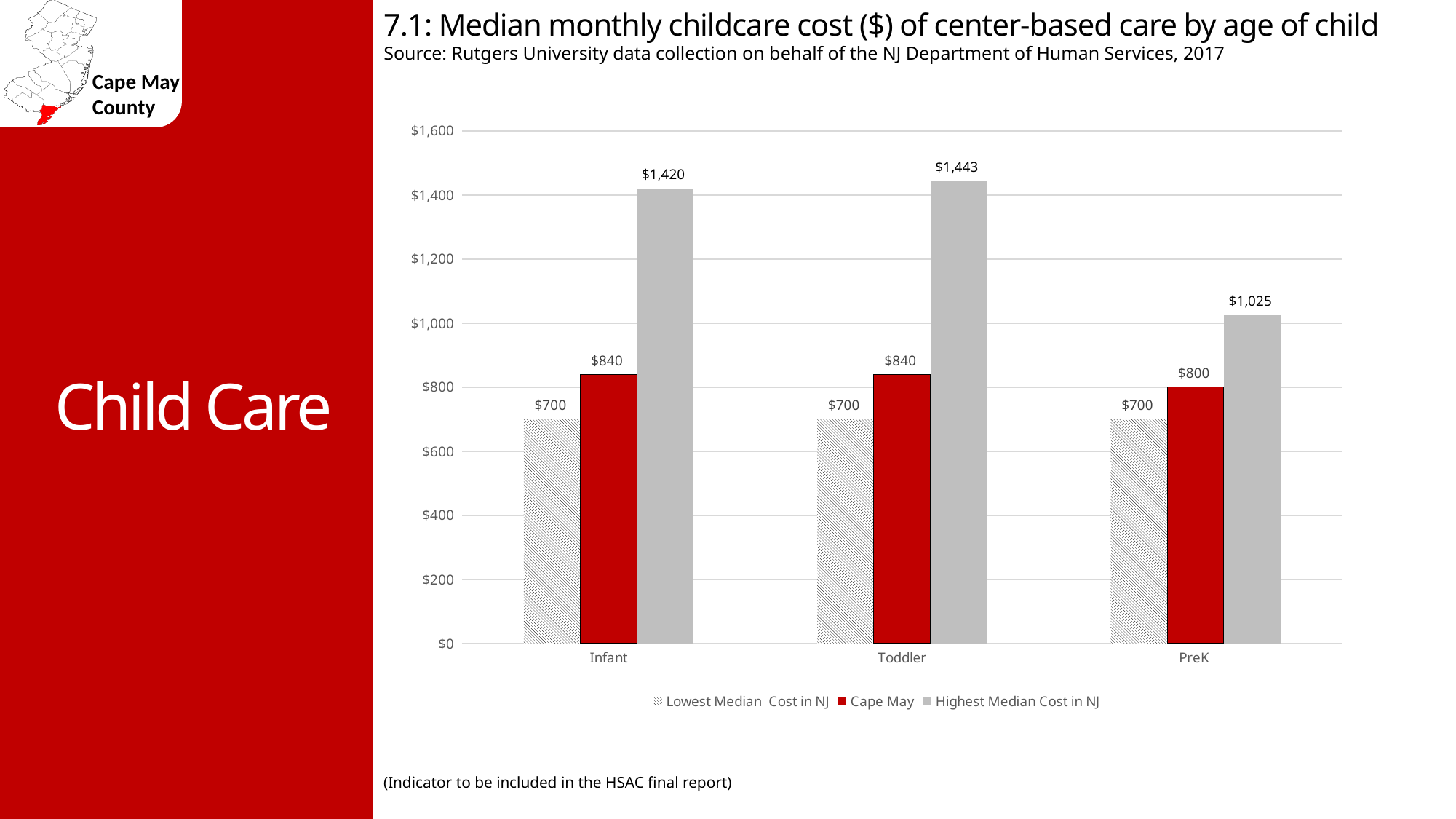
Which age group has the lowest Cape May value? PreK What is the Lowest Median Cost in NJ for PreK care? $700 How many age groups are shown on the x axis? 3 What kind of chart is shown on the slide? Bar chart What is the Highest Median Cost in NJ for Toddler care? $1,443 What is the difference between the Highest Median Cost in NJ and the Cape May value for Infant care? $580 Which age group has the highest value for the Highest Median Cost in NJ series? Toddler What is the Cape May median monthly childcare cost for Infant care? $840 What is the Cape May value for PreK? $800 What is the difference between the Cape May value and the Lowest Median Cost in NJ for PreK? $100 How many series does the legend list? 3 Which is larger: the Highest Median Cost in NJ for PreK or for Infant? Infant